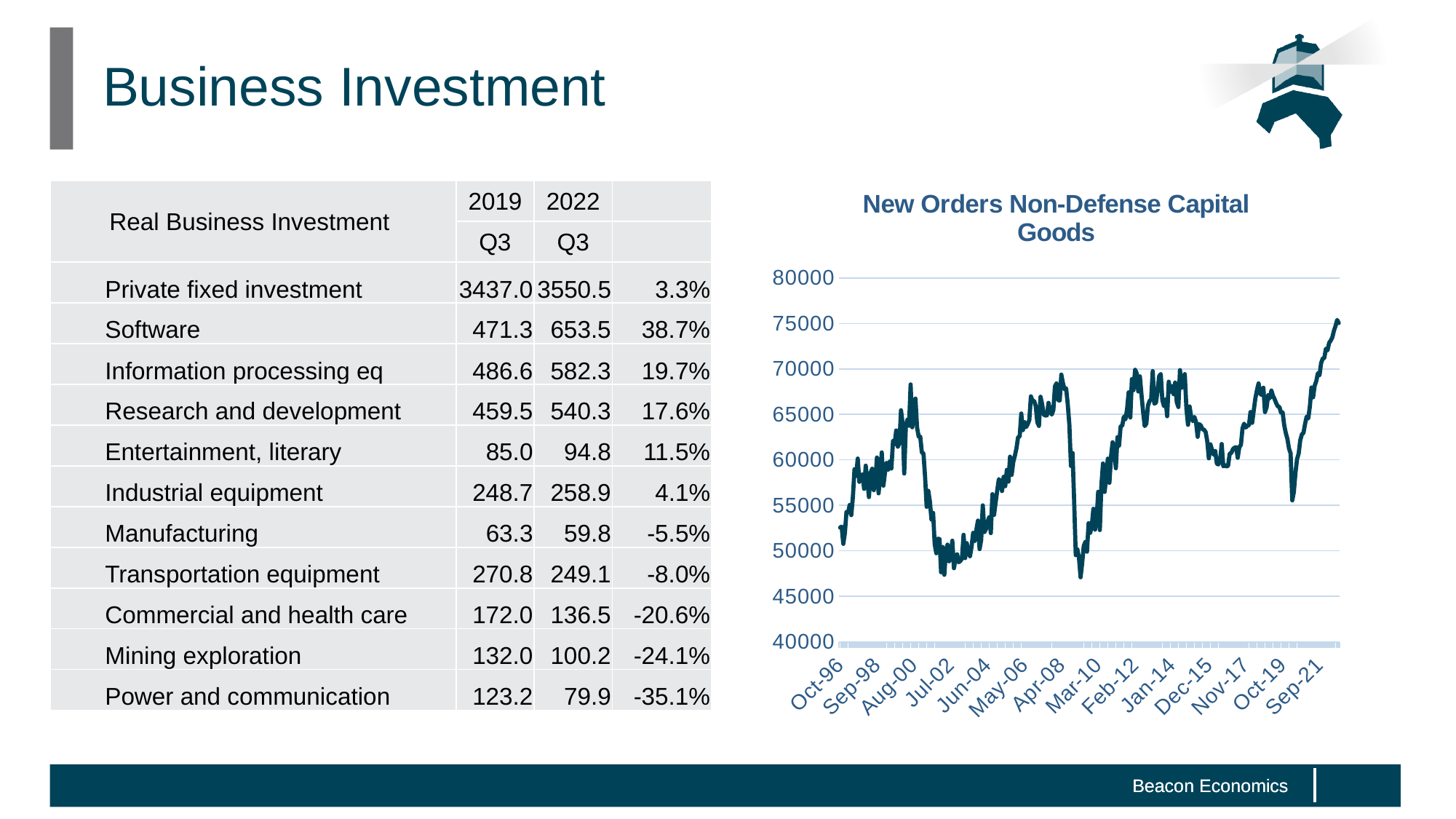
What is the highest value shown on the y axis of the 'New Orders Non-Defense Capital Goods' chart? 80000 In the 'New Orders Non-Defense Capital Goods' chart, does the line rise or fall between Oct-19 and Sep-21? rise What kind of chart is the 'New Orders Non-Defense Capital Goods' chart? line chart In the 'New Orders Non-Defense Capital Goods' chart, is the value higher at Jul-02 or at Apr-08? Apr-08 How many date labels are shown on the x axis of the 'New Orders Non-Defense Capital Goods' chart? 14 What is the title of the chart on the right side of the slide? New Orders Non-Defense Capital Goods In the 'New Orders Non-Defense Capital Goods' chart, is the value higher at Sep-21 or at Oct-96? Sep-21 In the 'New Orders Non-Defense Capital Goods' chart, is the value at Oct-96 greater or less than 55000? less In the 'New Orders Non-Defense Capital Goods' chart, does the line overall rise or fall from Oct-96 to Sep-21? rise In the 'New Orders Non-Defense Capital Goods' chart, is the lowest point of the line greater or less than 50000? less